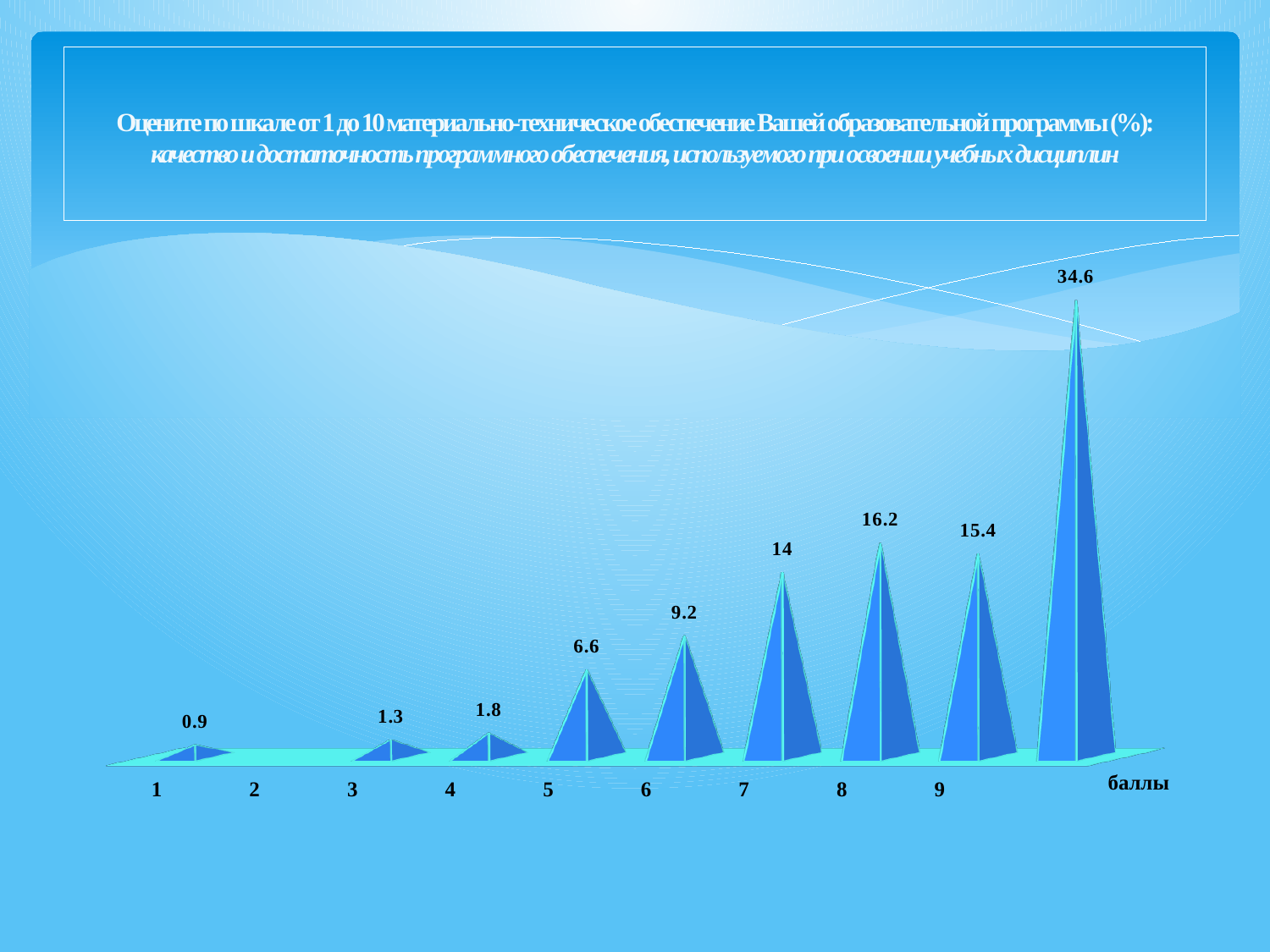
What is the difference between the values for score 7 and score 5? 7.4 What kind of chart is shown on the slide? bar chart What is the largest value shown on the chart? 34.6 What is the difference between the values for score 8 and score 9? 0.8 Which score has the smallest labelled value? 1 What is the value for score 5? 6.6 What is the value for score 1? 0.9 Which has a larger value, score 6 or score 7? 7 Which has a larger value, score 8 or score 9? 8 What is the value for score 8? 16.2 What label is written at the right end of the x axis? баллы What is the value for score 4? 1.8